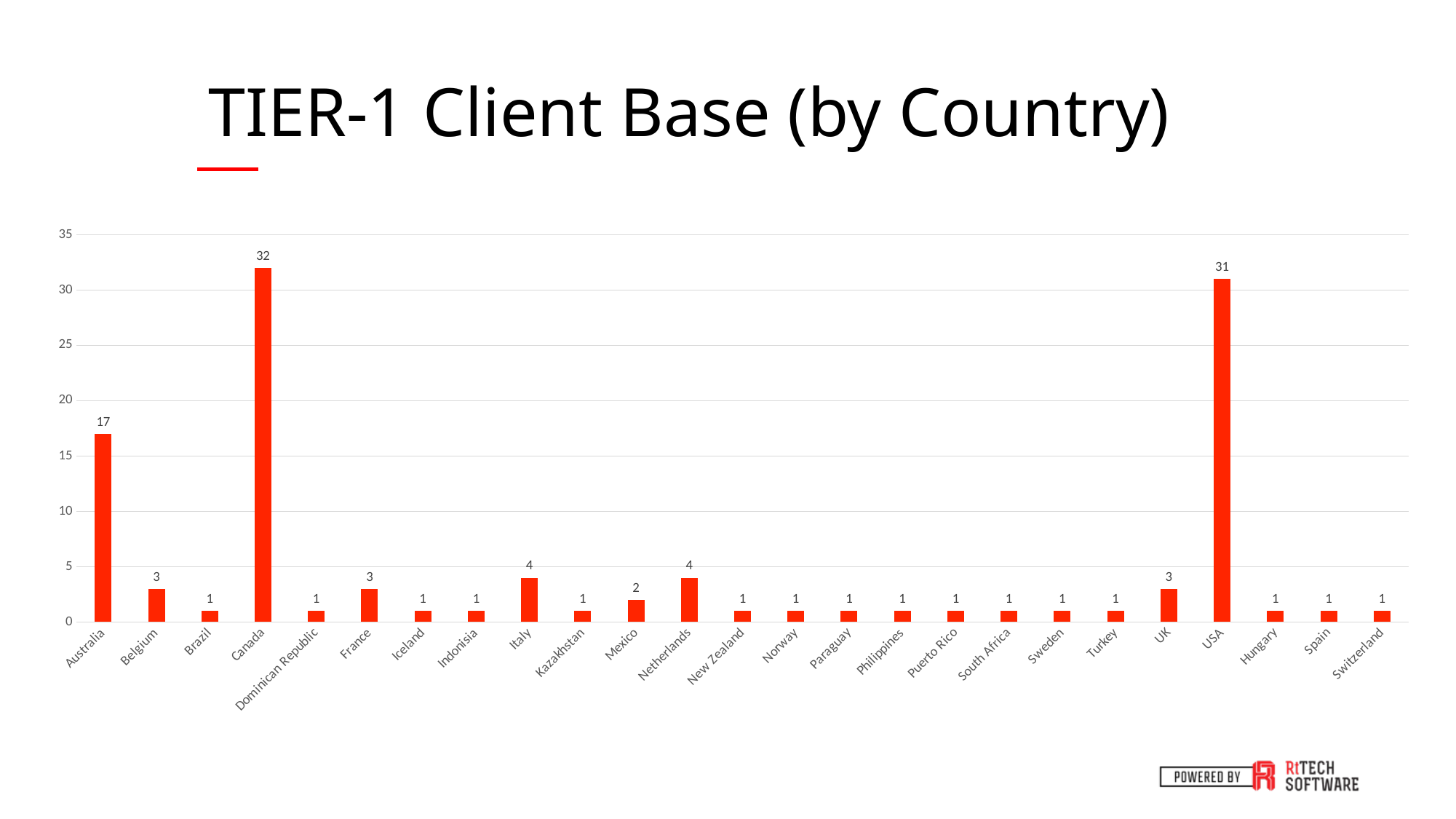
What is the value for UK? 3 What is the title of the slide? TIER-1 Client Base (by Country) What is the value for Netherlands? 4 How many countries are shown on the x axis? 25 What is the difference between the values for Canada and USA? 1 What is the difference between the values for Australia and Canada? 15 Which country has the highest value? Canada What kind of chart is shown on the slide? bar chart What is the value for Australia? 17 Which is larger, the value for Australia or the value for USA? USA What is the value for Canada? 32 Is the value for Australia greater or less than 15? greater